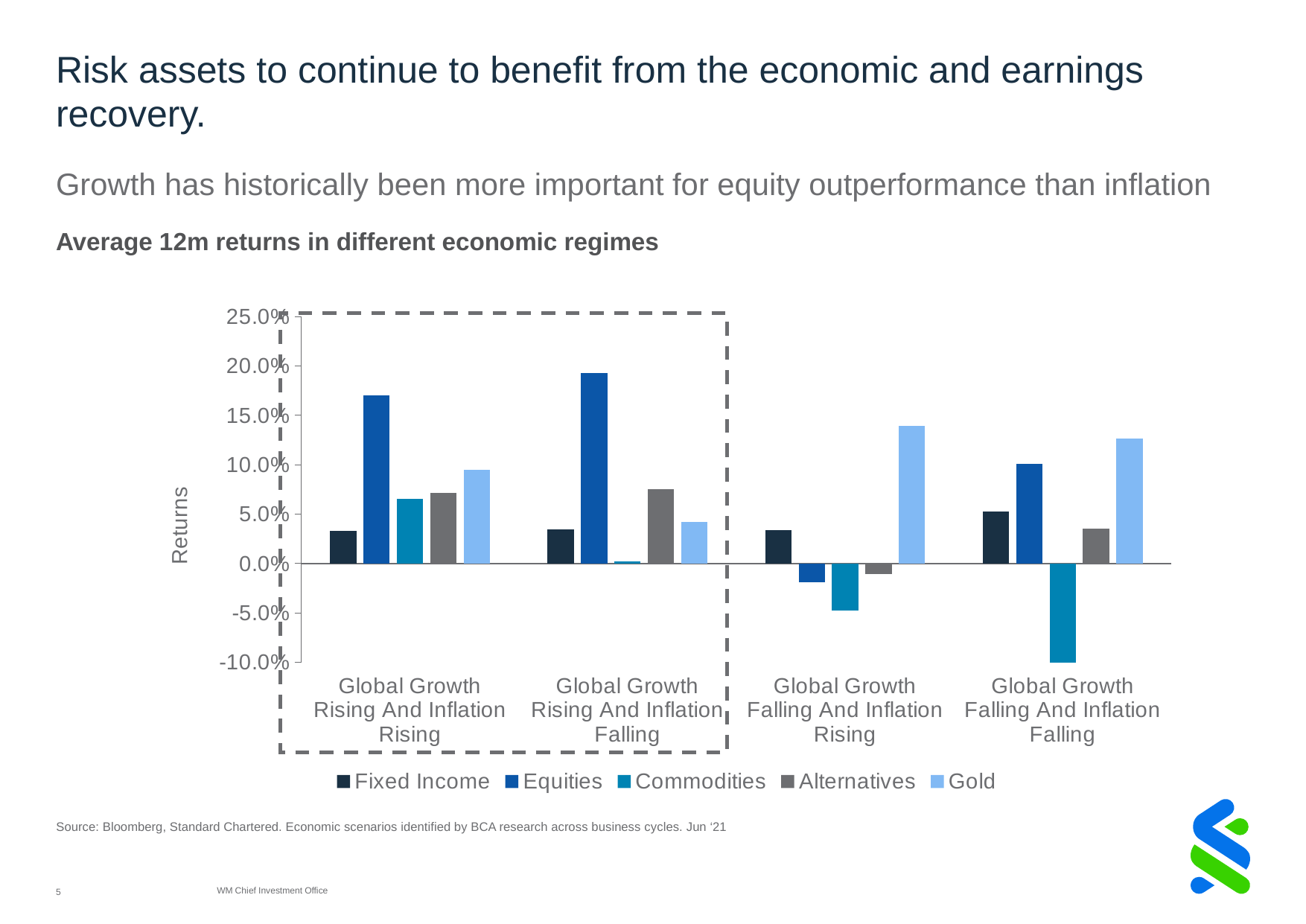
How many series does the legend list? 5 Is the Commodities return in the Global Growth Falling And Inflation Falling regime greater or less than -5.0%? less In the Global Growth Falling And Inflation Falling regime, which is larger: the Gold return or the Equities return? Gold Is the Gold return in the Global Growth Falling And Inflation Rising regime greater or less than 10.0%? greater How many economic regimes (categories) are shown on the x axis? 4 In the Global Growth Rising And Inflation Rising regime, which is larger: the Equities return or the Gold return? Equities What kind of chart is shown on the slide? Bar chart Is the Equities return in the Global Growth Rising And Inflation Rising regime greater or less than 15.0%? greater What is the title of the chart? Average 12m returns in different economic regimes In which economic regime is the Equities return highest? Global Growth Rising And Inflation Falling In which economic regime is the Commodities return lowest? Global Growth Falling And Inflation Falling In the Global Growth Falling And Inflation Rising regime, which asset class has the highest return? Gold